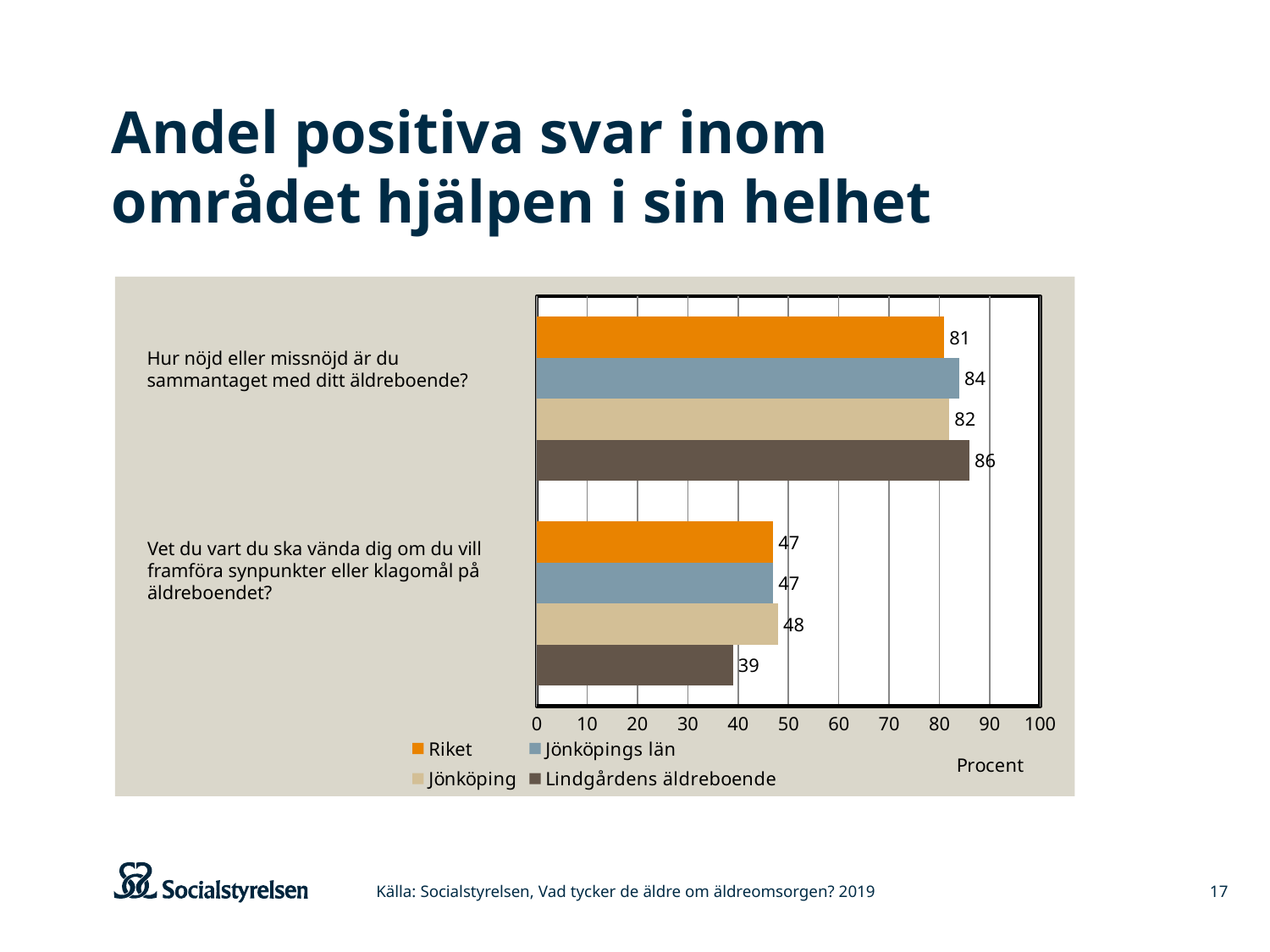
What is the value for Jönköpings län on the question "Hur nöjd eller missnöjd är du sammantaget med ditt äldreboende?"? 84 Is the value for Lindgårdens äldreboende on the question "Vet du vart du ska vända dig om du vill framföra synpunkter eller klagomål på äldreboendet?" greater or less than 40? less On the question "Hur nöjd eller missnöjd är du sammantaget med ditt äldreboende?", which is larger: the value for Jönköpings län or the value for Jönköping? Jönköpings län What is the value for Lindgårdens äldreboende on the question "Vet du vart du ska vända dig om du vill framföra synpunkter eller klagomål på äldreboendet?"? 39 What is the difference between the Lindgårdens äldreboende value and the Riket value on the question "Hur nöjd eller missnöjd är du sammantaget med ditt äldreboende?"? 5 What is the label of the horizontal axis of the chart? Procent What is the value for Riket on the question "Hur nöjd eller missnöjd är du sammantaget med ditt äldreboende?"? 81 How many series does the legend list? 4 What kind of chart is shown on the slide? Bar chart What is the difference between the Jönköping value and the Lindgårdens äldreboende value on the question "Vet du vart du ska vända dig om du vill framföra synpunkter eller klagomål på äldreboendet?"? 9 Which series has the lowest value on the question "Vet du vart du ska vända dig om du vill framföra synpunkter eller klagomål på äldreboendet?"? Lindgårdens äldreboende Which series has the highest value on the question "Hur nöjd eller missnöjd är du sammantaget med ditt äldreboende?"? Lindgårdens äldreboende